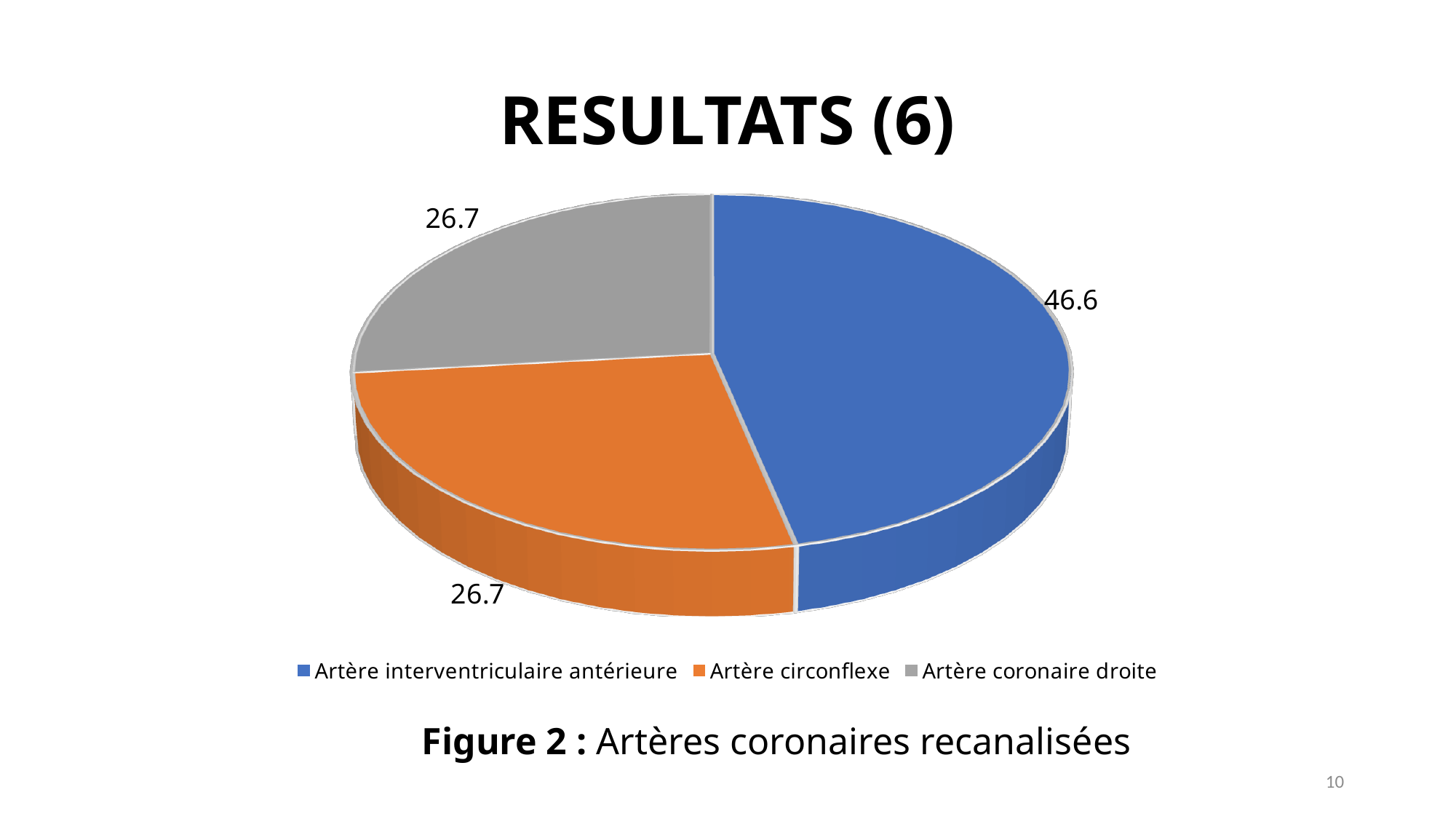
What value is shown for Artère interventriculaire antérieure? 46.6 How many slices does the pie chart have? 3 What is the total of the three values shown on the pie chart? 100.0 What value is shown for Artère circonflexe? 26.7 How many entries does the legend list? 3 Which artery has the largest slice of the pie? Artère interventriculaire antérieure Which colour represents Artère circonflexe in the chart? Orange Which is larger, the slice for Artère interventriculaire antérieure or the slice for Artère circonflexe? Artère interventriculaire antérieure What kind of chart is shown on the slide? Pie chart What is the caption given below the chart? Figure 2 : Artères coronaires recanalisées What is the difference between the values for Artère interventriculaire antérieure and Artère coronaire droite? 19.9 What value is shown for Artère coronaire droite? 26.7